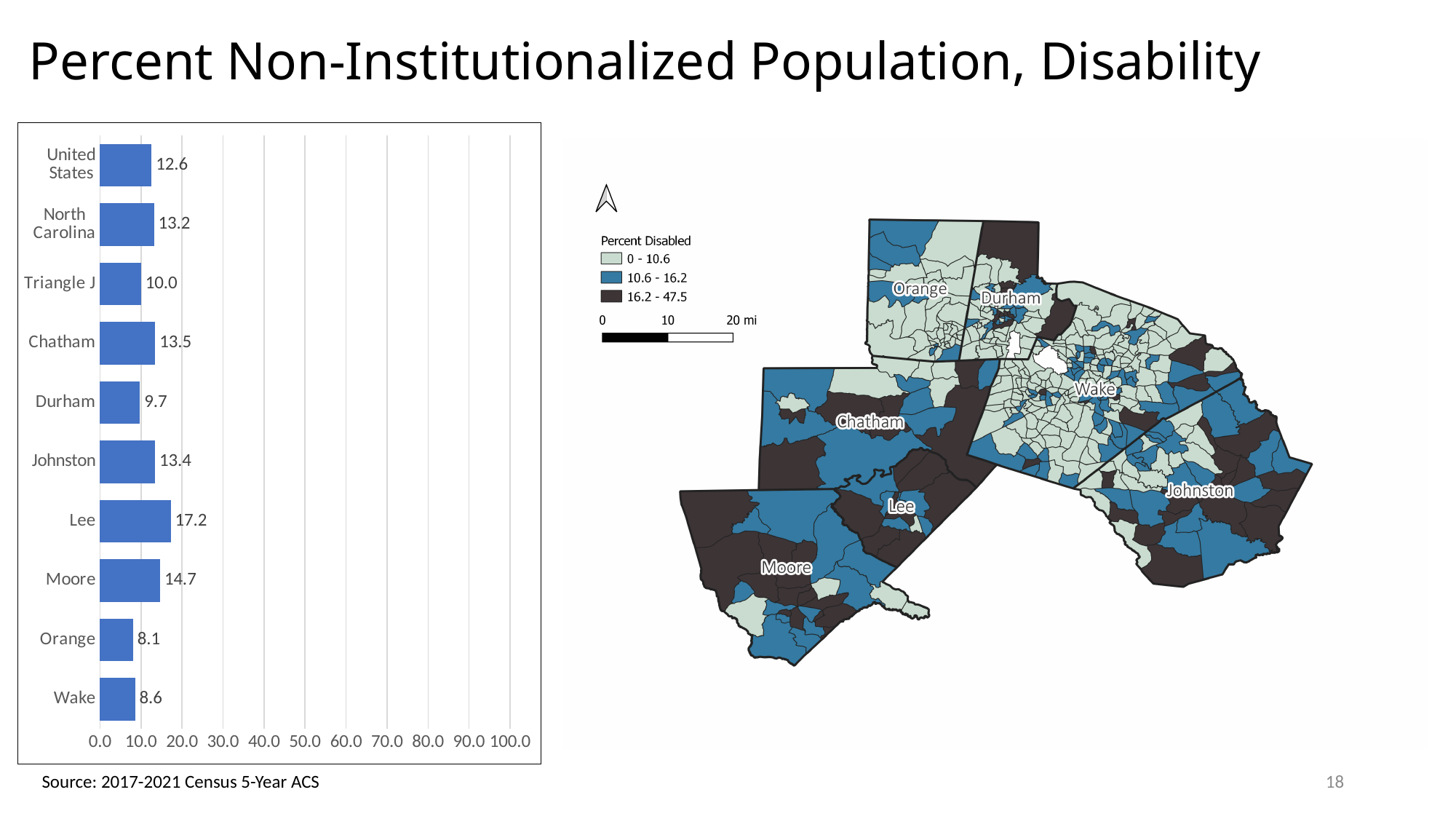
Which category has the highest value in the bar chart? Lee Which has a larger value in the bar chart, Moore or Chatham? Moore What is the value for Triangle J in the bar chart? 10.0 Which category has the lowest value in the bar chart? Orange What is the maximum value shown on the x axis of the bar chart? 100.0 What is the value for Lee in the bar chart? 17.2 What is the value for Orange in the bar chart? 8.1 What is the difference between the values for Lee and Wake in the bar chart? 8.6 Is the value for Durham in the bar chart greater or less than 10.0? less How many categories are shown in the bar chart? 10 What is the value for North Carolina in the bar chart? 13.2 What kind of chart is shown on the left of the slide? bar chart